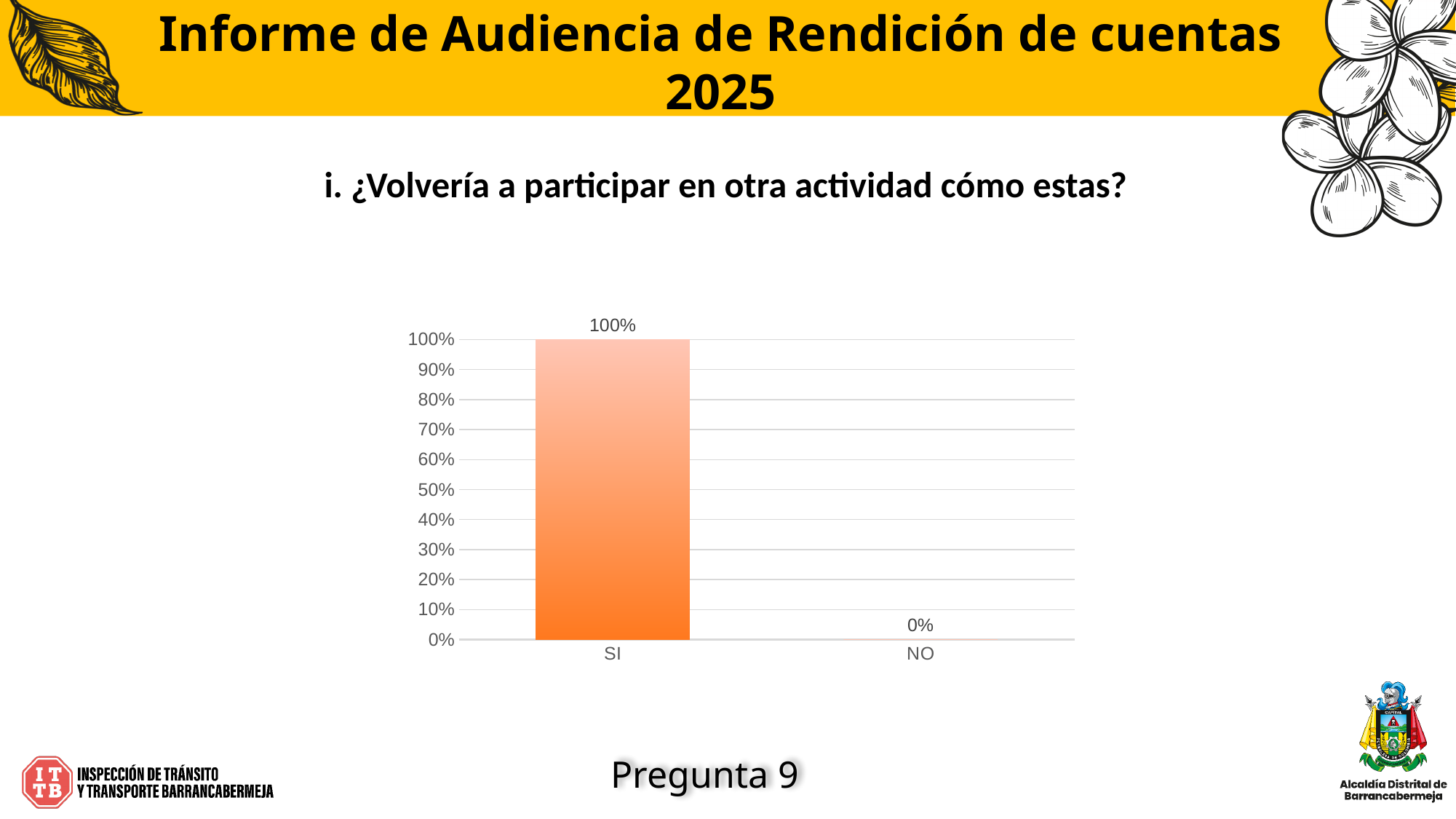
What is the difference between the values for SI and NO? 100% What question does the chart on the slide report results for? ¿Volvería a participar en otra actividad cómo estas? How many categories are shown on the x axis? 2 What is the value for SI? 100% What is the highest tick value shown on the y axis? 100% Which category has the highest value? SI What kind of chart is shown on the slide? bar chart What is the value for NO? 0% Which category has the lowest value? NO Is the value for SI greater or less than 50%? greater Do the values rise or fall from SI to NO? fall Which is larger, the value for SI or the value for NO? SI